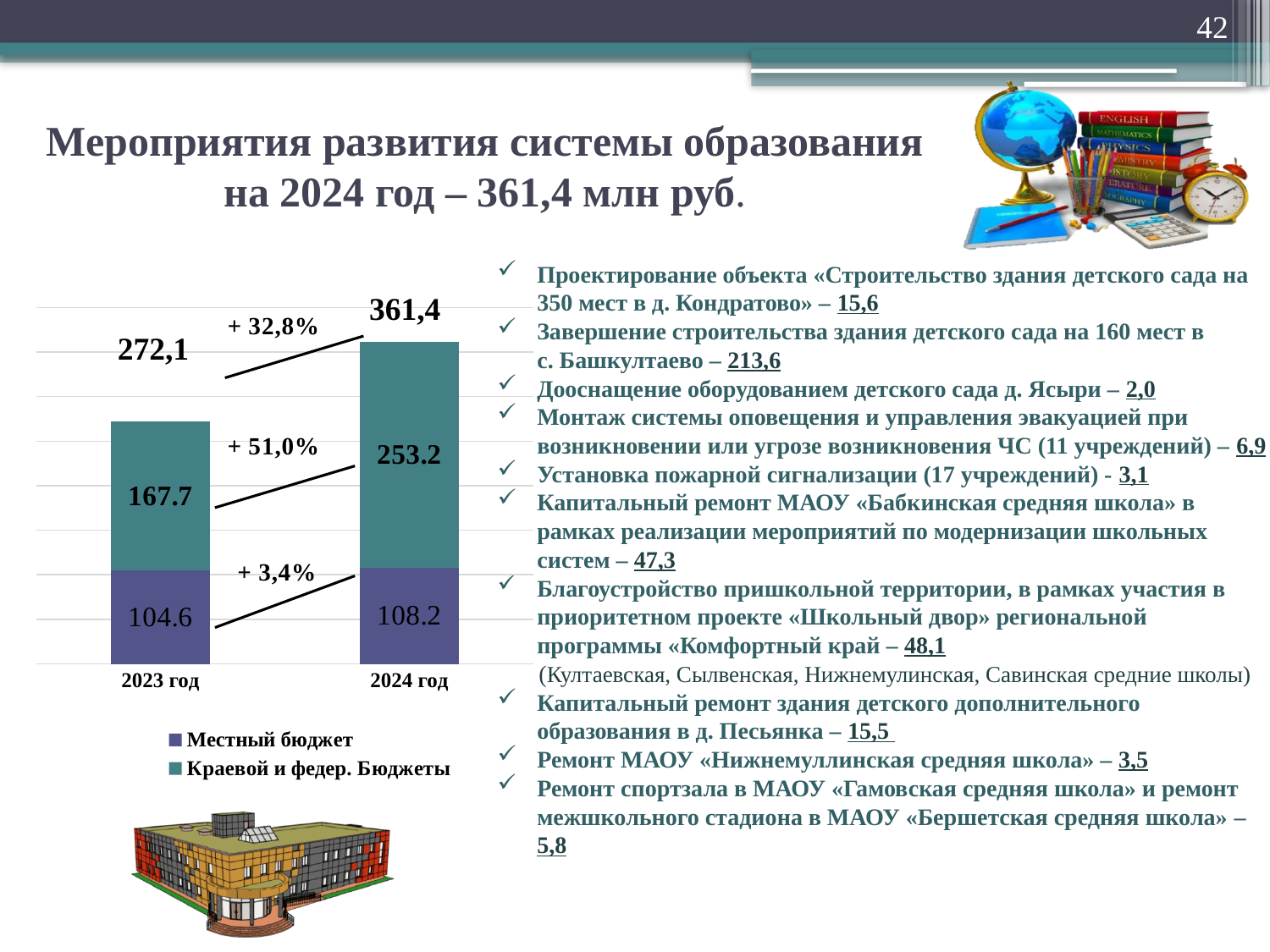
What is the difference between the Краевой и федер. Бюджеты values for 2024 год and 2023 год? 85.5 What is the total of the stacked bar for 2024 год? 361,4 How many series does the chart legend list? 2 What is the value of Краевой и федер. Бюджеты for 2024 год? 253.2 What is the value of Местный бюджет for 2023 год? 104.6 Which year has the larger value for Краевой и федер. Бюджеты, 2023 год or 2024 год? 2024 год What is the value of Местный бюджет for 2024 год? 108.2 What percentage growth is annotated between the totals for 2023 год and 2024 год? + 32,8% What is the total of the stacked bar for 2023 год? 272,1 How many categories (years) are shown on the x axis of the chart? 2 What kind of chart is shown on the slide? Stacked bar chart What is the value of Краевой и федер. Бюджеты for 2023 год? 167.7